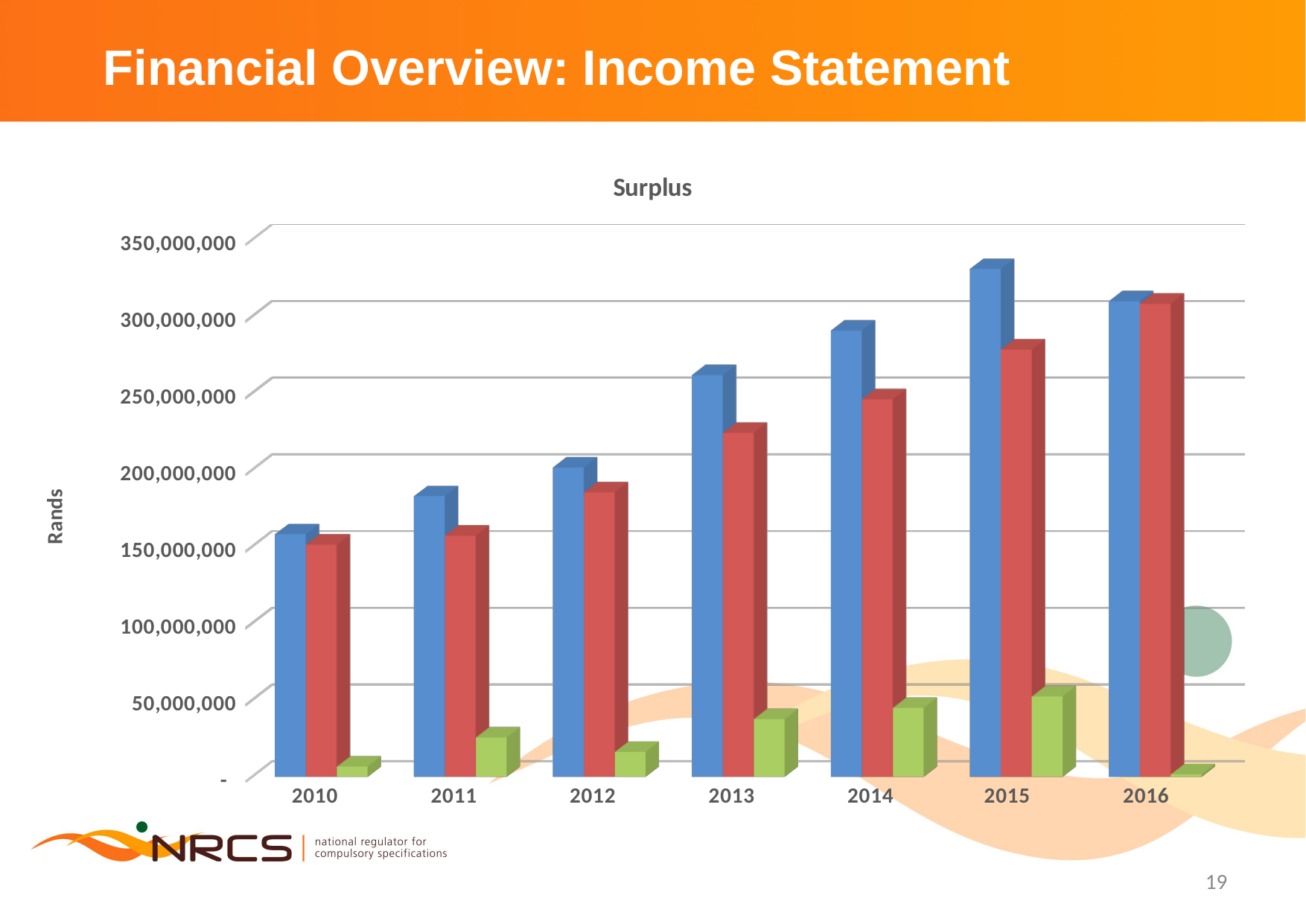
Is the value of the blue bar for 2015 greater or less than 300,000,000? greater How many years are shown on the x axis of the chart? 7 What is the label on the vertical axis of the chart? Rands Is the value of the red bar for 2013 greater or less than 250,000,000? less What kind of chart is shown on the slide? bar chart What is the title of the chart? Surplus Is the value of the blue bar for 2014 greater or less than 300,000,000? less In which year is the blue bar the tallest? 2015 In 2015, which is larger, the blue bar or the red bar? blue bar In which year is the green bar the lowest? 2016 Do the red bars rise or fall from 2010 to 2016? rise